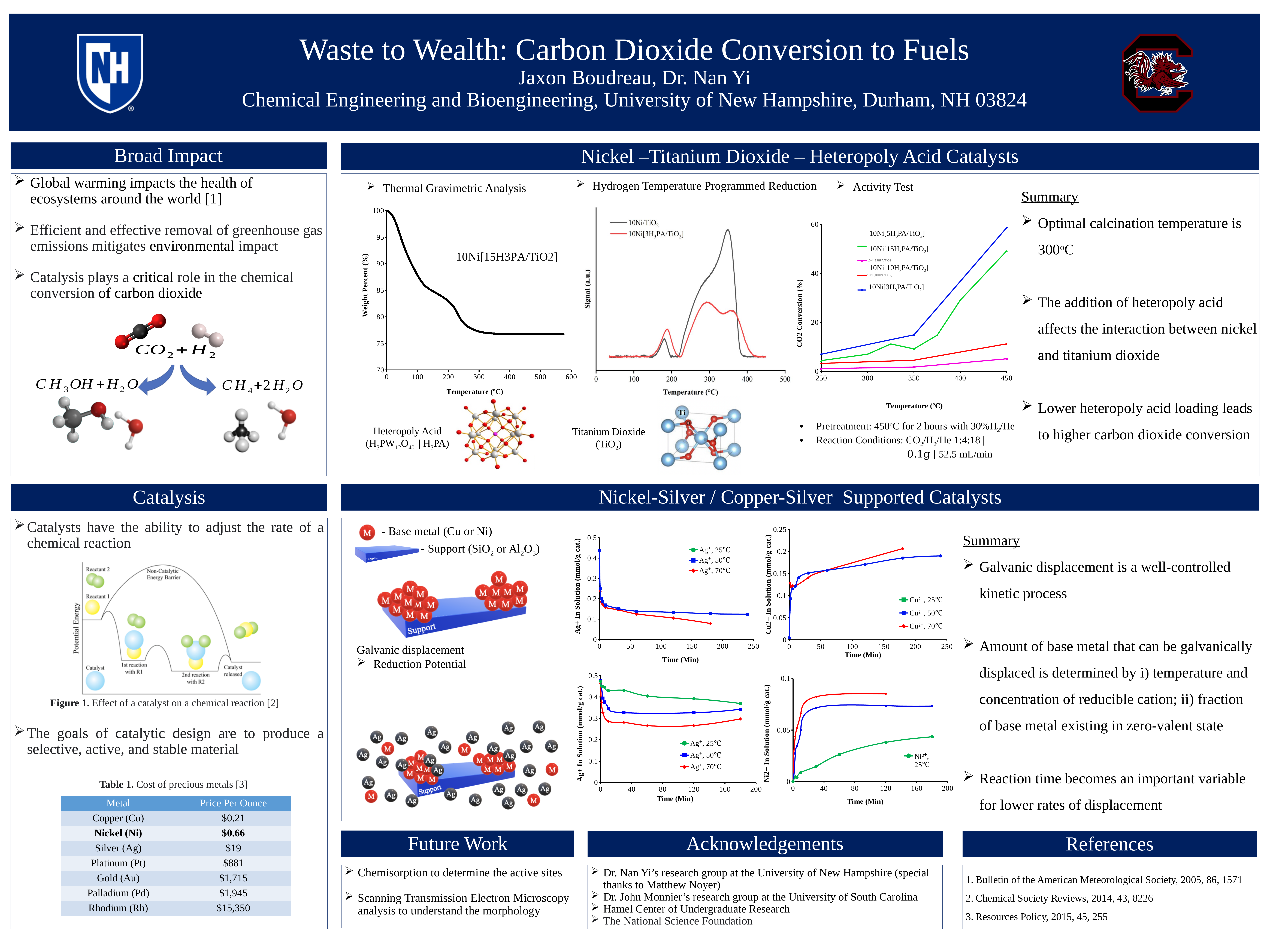
In the Activity Test chart, is the CO2 conversion of 10Ni[3H3PA/TiO2] at 450 °C greater or less than 40? greater In the lower Ag+ In Solution chart (x axis 0–200 min), which series has the lowest value at 180 min? Ag+, 70°C In the Cu2+ In Solution chart, does the Cu2+ concentration rise or fall over time? rise In the Thermal Gravimetric Analysis chart, is the weight percent at 500 °C greater or less than 80? less In the Cu2+ In Solution chart, is the value for Cu2+, 50°C at 240 min greater or less than 0.15? greater How many series does the legend of the Ni2+ In Solution chart list? 1 How many series does the legend of the Cu2+ In Solution chart list? 3 What kind of chart is the Thermal Gravimetric Analysis chart? line chart In the Thermal Gravimetric Analysis chart, does the weight percent rise or fall as temperature increases? fall What is the x-axis label of the Activity Test chart? Temperature (°C) How many series does the legend of the Hydrogen Temperature Programmed Reduction chart list? 2 In the Activity Test chart, which series has the highest CO2 conversion at 450 °C? 10Ni[3H3PA/TiO2]